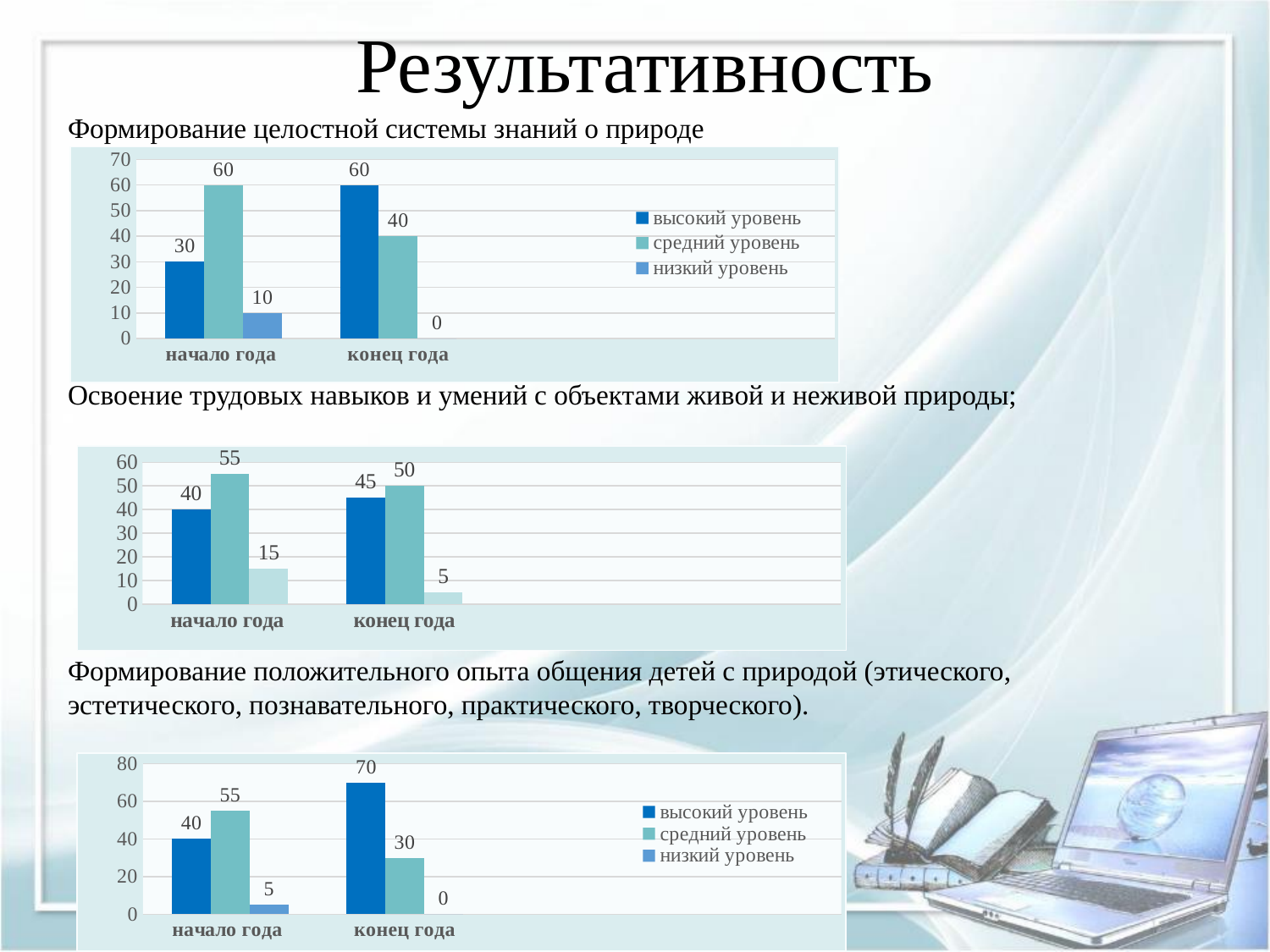
In the bottom chart (Формирование положительного опыта общения детей с природой), what is the difference between средний уровень at начало года and at конец года? 25 In the top chart (Формирование целостной системы знаний о природе), what is the value for низкий уровень at конец года? 0 In the top chart (Формирование целостной системы знаний о природе), how many series does the legend list? 3 In the bottom chart (Формирование положительного опыта общения детей с природой), which is larger at начало года: высокий уровень or средний уровень? средний уровень In the bottom chart (Формирование положительного опыта общения детей с природой), what is the value for высокий уровень at конец года? 70 In the top chart (Формирование целостной системы знаний о природе), which series has the highest value at начало года? средний уровень In the middle chart (Освоение трудовых навыков и умений), how many categories are shown on the x axis? 2 In the top chart (Формирование целостной системы знаний о природе), by how much does высокий уровень change from начало года to конец года? 30 What type of chart is the bottom chart (Формирование положительного опыта общения детей с природой)? bar chart In the middle chart (Освоение трудовых навыков и умений), what is the value of the lightest-coloured bar at конец года? 5 In the middle chart (Освоение трудовых навыков и умений), what is the value of the tallest bar at начало года? 55 In the top chart (Формирование целостной системы знаний о природе), what is the value for высокий уровень at начало года? 30